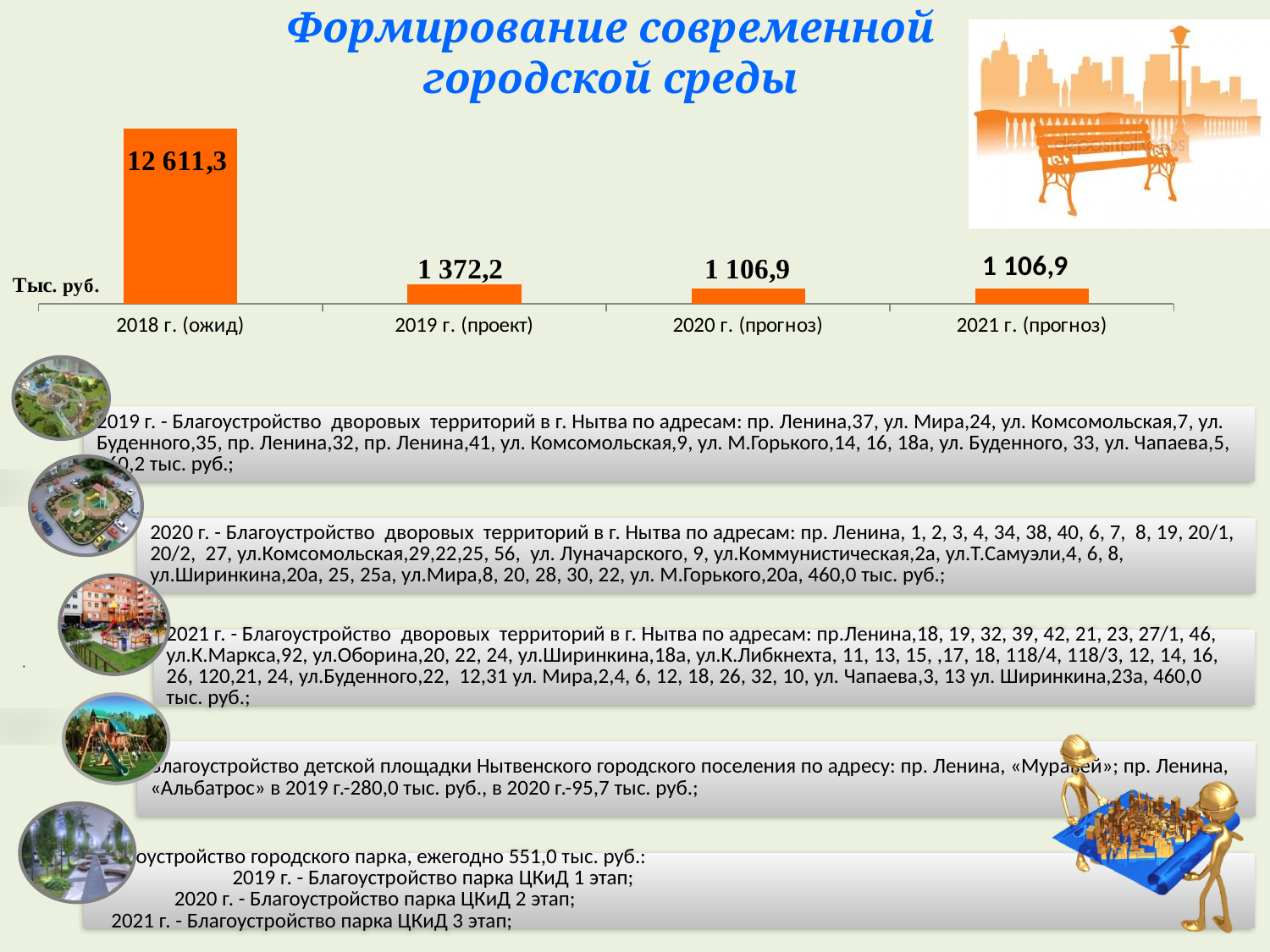
What is the value for 2021 г. (прогноз) on the chart? 1 106,9 What unit is indicated for the values on the chart? Тыс. руб. Which is larger, the value for 2019 г. (проект) or the value for 2021 г. (прогноз)? 2019 г. (проект) What is the value for 2019 г. (проект) on the chart? 1 372,2 Which category has the highest value on the chart? 2018 г. (ожид) What is the difference between the values for 2018 г. (ожид) and 2019 г. (проект)? 11 239,1 What is the difference between the values for 2019 г. (проект) and 2020 г. (прогноз)? 265,3 What kind of chart is shown on the slide? bar chart What is the value for 2018 г. (ожид) on the chart? 12 611,3 How many categories are shown on the chart? 4 Do the values rise or fall from 2018 г. (ожид) to 2020 г. (прогноз)? fall What is the value for 2020 г. (прогноз) on the chart? 1 106,9